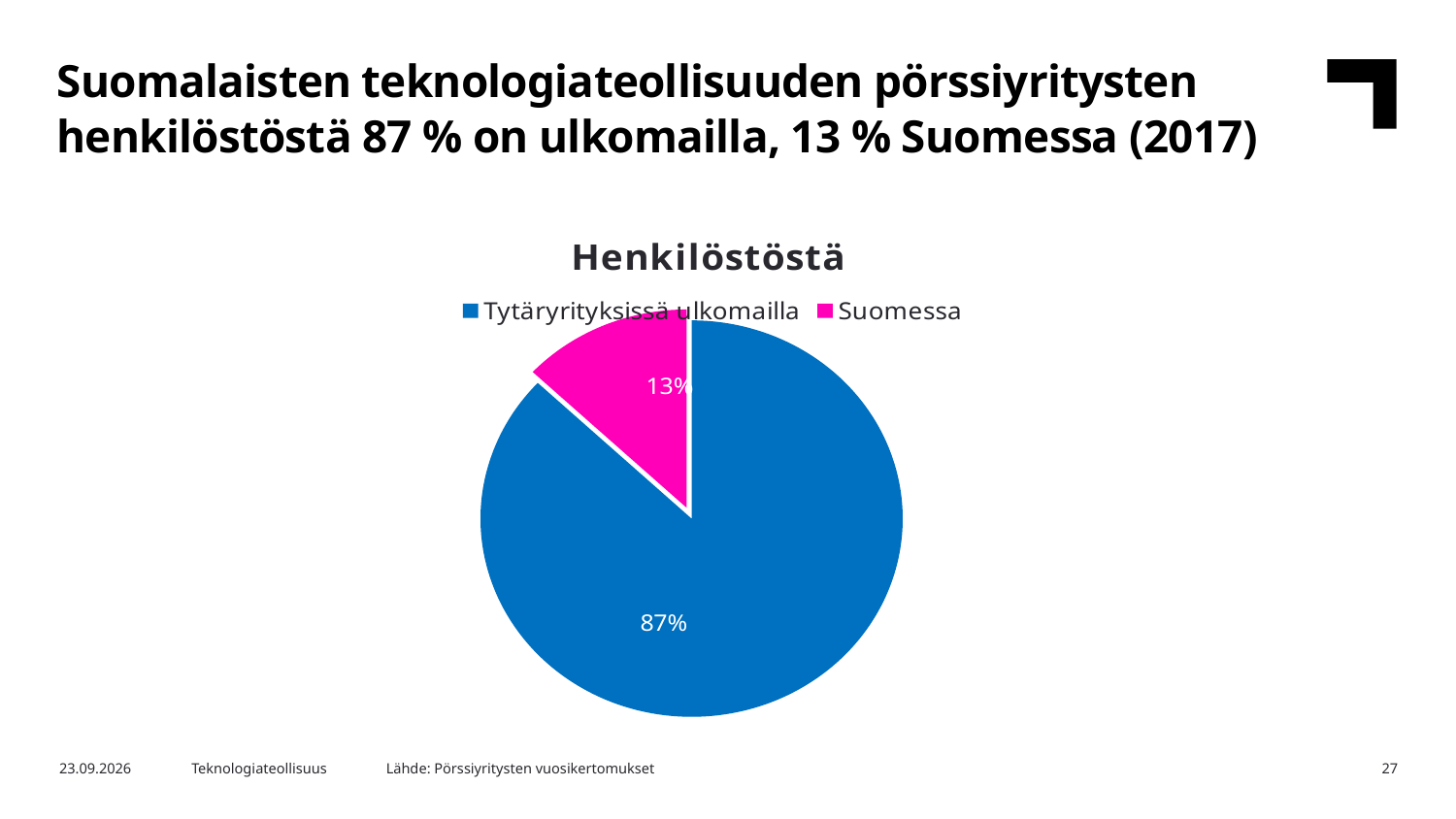
Which category has the smallest share of the pie? Suomessa How many slices does the pie chart have? 2 What kind of chart is shown on the slide? Pie chart What is the title of the chart? Henkilöstöstä What share of the pie does Tytäryrityksissä ulkomailla represent? 87% What share of the pie does Suomessa represent? 13% What colour is the Suomessa slice? Magenta (pink) What is the difference in percentage points between the Tytäryrityksissä ulkomailla share and the Suomessa share? 74 percentage points How many entries does the legend list? 2 Which category has the largest share of the pie? Tytäryrityksissä ulkomailla Is the share for Suomessa greater or less than 50%? less Which is larger, the share for Suomessa or the share for Tytäryrityksissä ulkomailla? Tytäryrityksissä ulkomailla